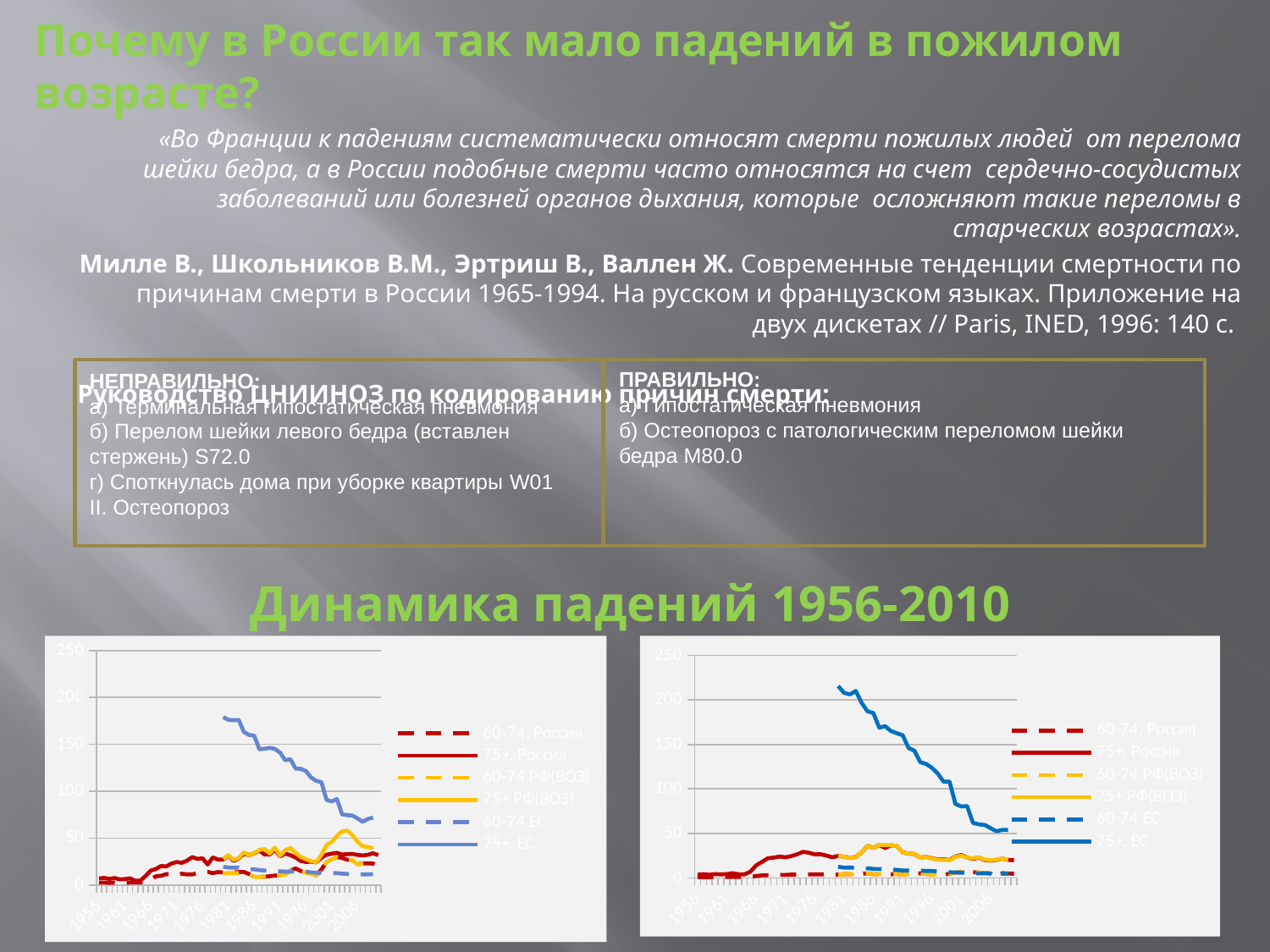
In the right chart, is the value for "75+, ЕС" in 2006 greater or less than 100? less In the left chart, does the value for the "75+, ЕС" series rise or fall from 1981 to 2006? fall What is the highest value shown on the y axis of the left chart? 250 In the left chart, is the value for "75+, Россия" in 1981 greater or less than 100? less What kind of chart is the left chart under "Динамика падений 1956-2010"? line chart In the right chart, does the value for the "75+, ЕС" series rise or fall from 1981 to 2006? fall How many series does the legend of the right chart under "Динамика падений 1956-2010" list? 6 In the right chart, is the value for "75+, ЕС" in 1981 greater or less than 150? greater In the left chart, does the value for "75+, Россия" rise or fall from 1956 to 1981? rise In the right chart, which is larger in 1981: the value for "75+, ЕС" or the value for "75+, Россия"? 75+, ЕС What is the heading above the two line charts on the slide? Динамика падений 1956-2010